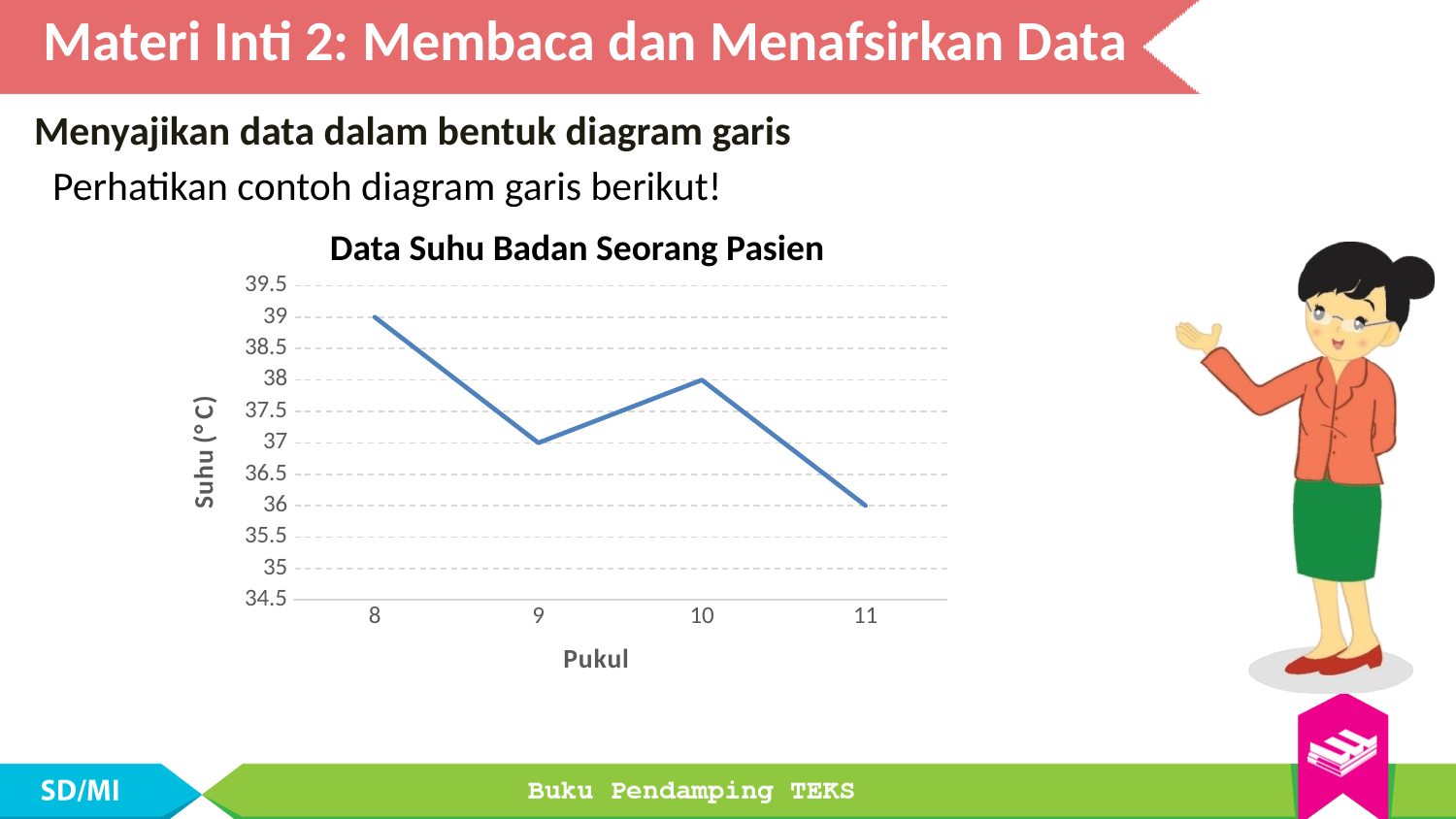
What is the label of the vertical axis? Suhu (°C) What is the difference between the temperature at pukul 8 and at pukul 11? 3 At which pukul is the temperature highest? 8 What is the temperature (Suhu) at pukul 8? 39 Which is higher, the temperature at pukul 9 or at pukul 10? pukul 10 What is the temperature (Suhu) at pukul 9? 37 How many time points (pukul) are plotted on the chart? 4 What is the title of the chart? Data Suhu Badan Seorang Pasien What kind of chart is shown on the slide? line chart What is the temperature (Suhu) at pukul 10? 38 At which pukul is the temperature lowest? 11 What is the temperature (Suhu) at pukul 11? 36